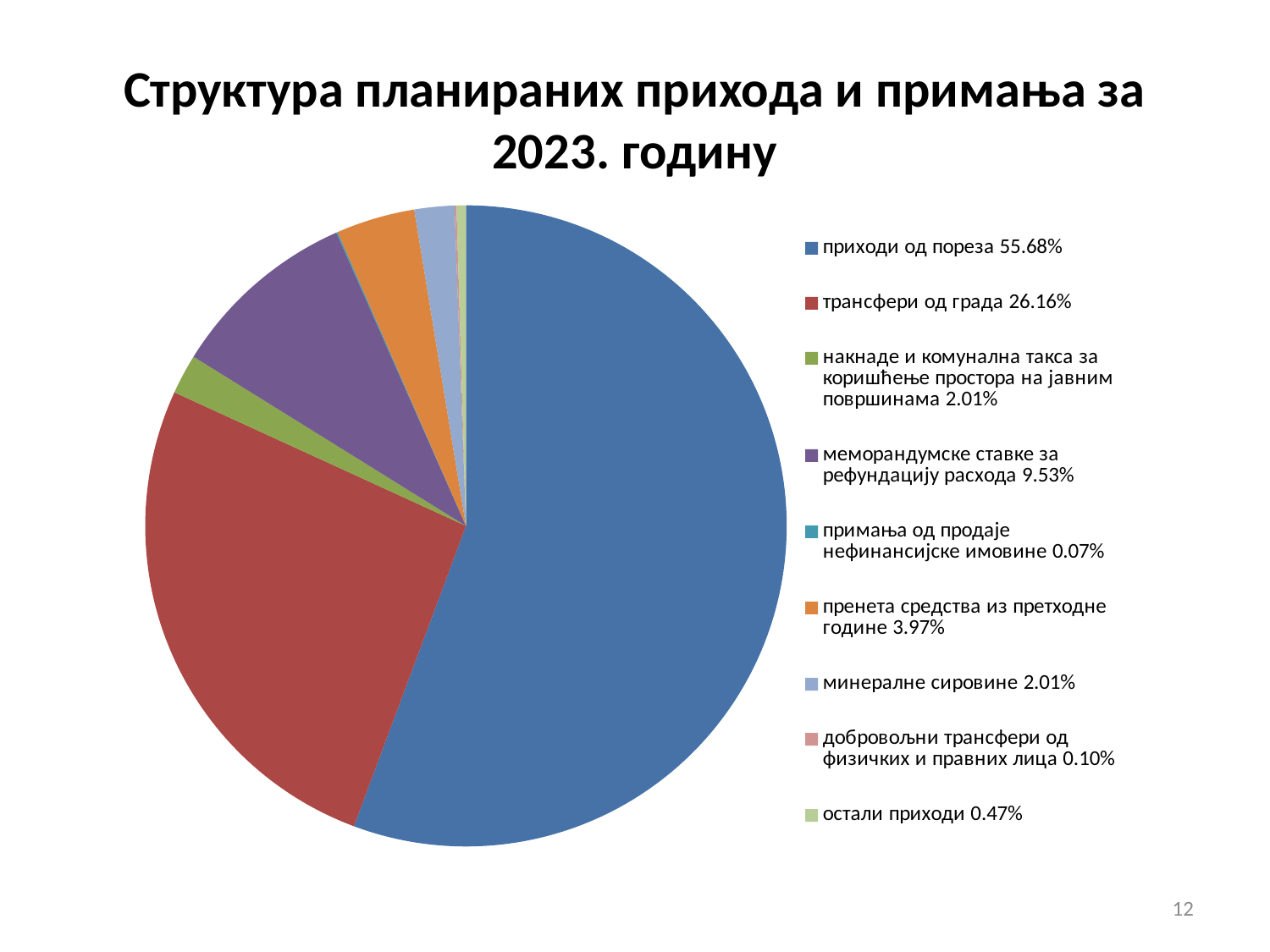
What is the title of the chart? Структура планираних прихода и примања за 2023. годину Which category has the largest share of the pie? приходи од пореза How many categories does the pie chart have? 9 What share of the pie does "приходи од пореза" represent? 55.68% What kind of chart is shown on the slide? pie chart What is the value for "меморандумске ставке за рефундацију расхода"? 9.53% What is the difference between the shares of "меморандумске ставке за рефундацију расхода" and "пренета средства из претходне године"? 5.56% What is the value for "пренета средства из претходне године"? 3.97% What is the value for "трансфери од града"? 26.16% Which category has the smallest share of the pie? примања од продаје нефинансијске имовине Which is larger: the share of "трансфери од града" or the share of "меморандумске ставке за рефундацију расхода"? трансфери од града What is the difference between the shares of "приходи од пореза" and "трансфери од града"? 29.52%